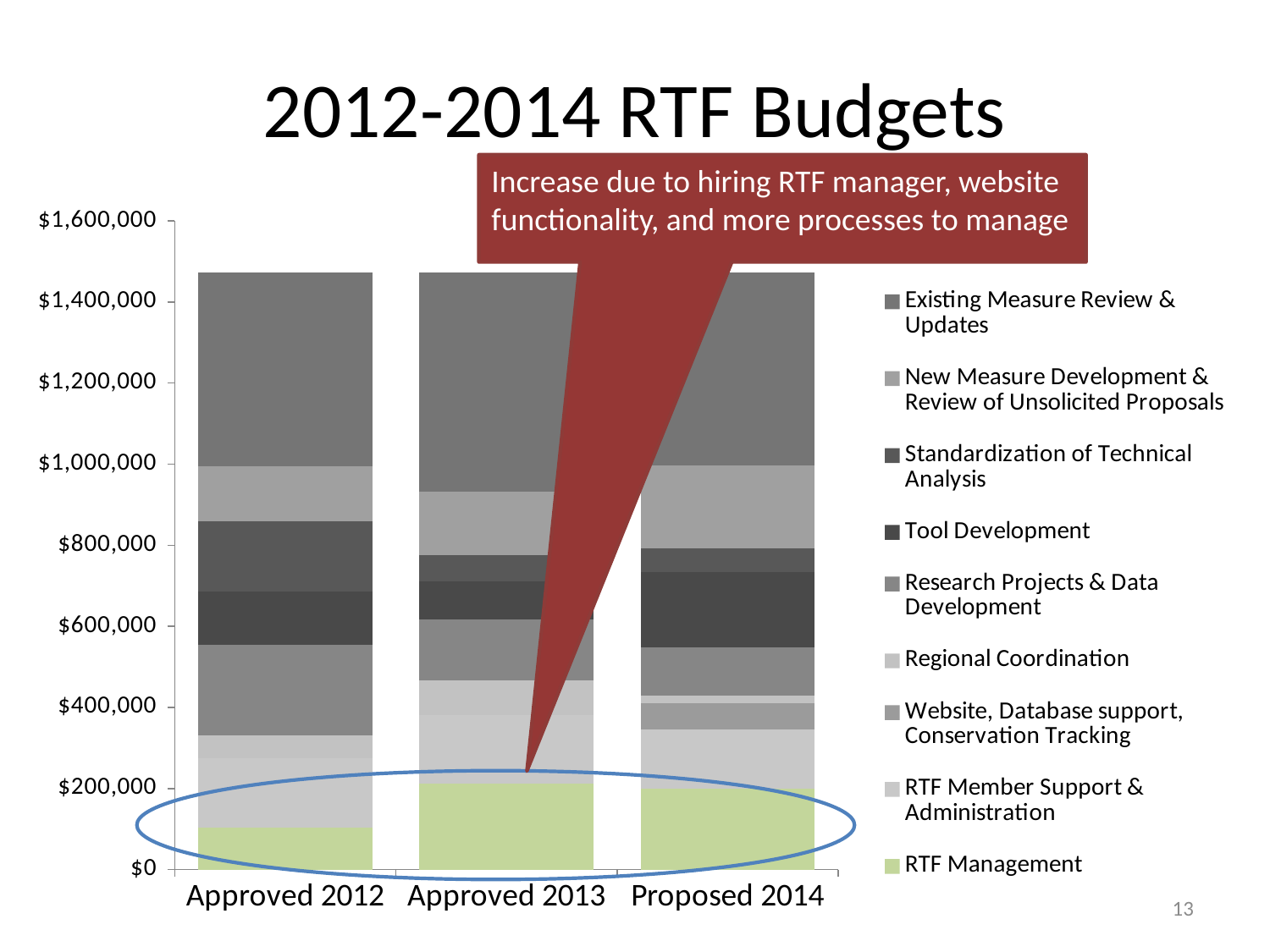
How many series does the legend list? 9 Which series appears at the bottom of each stacked bar? RTF Management Which category has the lowest RTF Management value? Approved 2012 Is the RTF Management value for Approved 2012 greater or less than $200,000? less Which series is shown in green in the legend? RTF Management Is the total bar for Proposed 2014 greater or less than $1,600,000? less How many budget years (categories) are shown on the x axis? 3 Is the total bar for Approved 2013 greater or less than $1,200,000? greater What is the title of the chart? 2012-2014 RTF Budgets What kind of chart is shown on the slide? Stacked bar chart Which has the larger RTF Management value, Approved 2012 or Approved 2013? Approved 2013